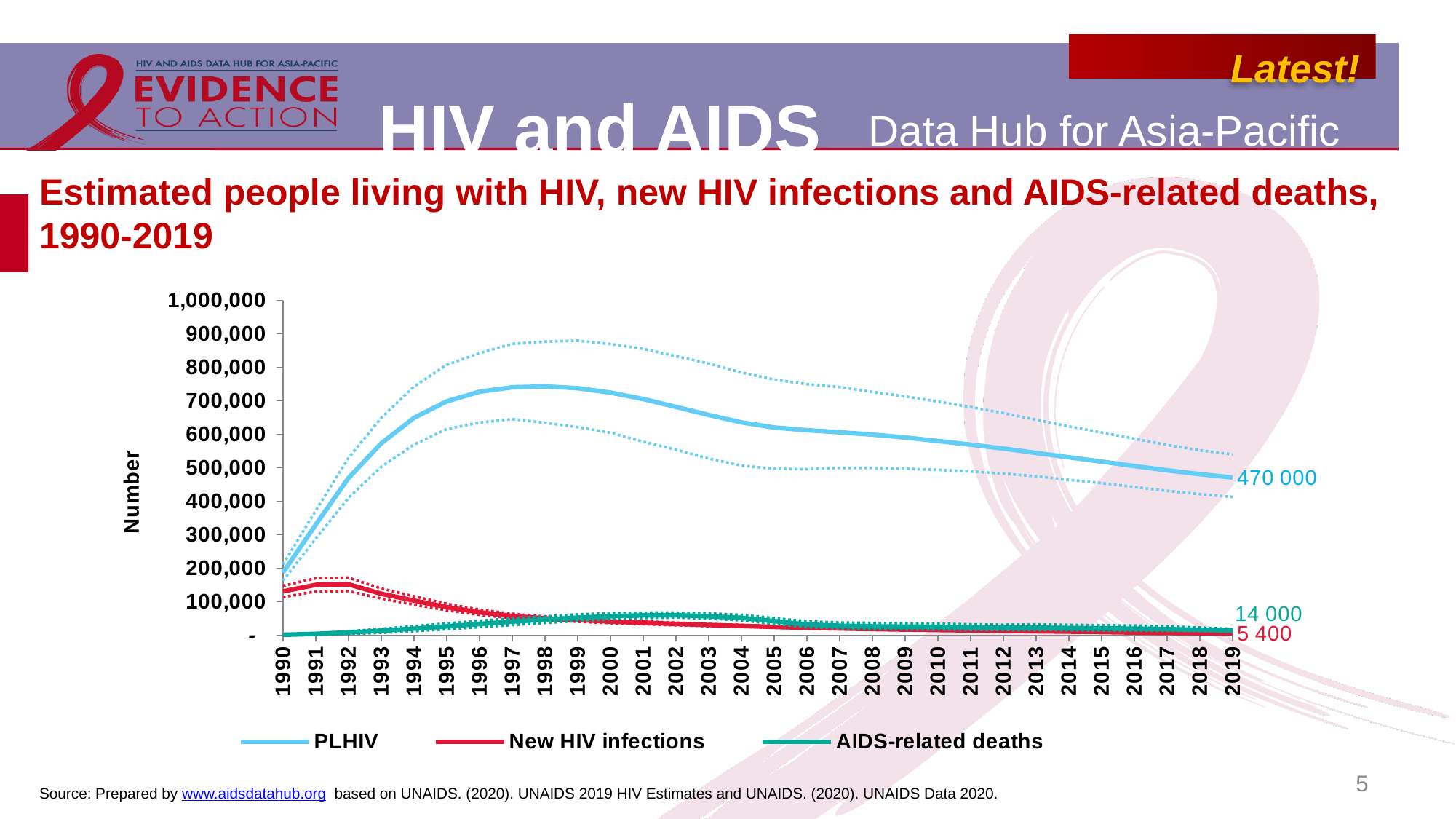
How many series does the legend list? 3 In 2019, which is larger: AIDS-related deaths or New HIV infections? AIDS-related deaths Does the PLHIV line rise or fall from 1998 to 2019? fall What kind of chart is shown on the slide? line chart Which series has the highest value in 2019? PLHIV What is the value for New HIV infections in 2019? 5 400 What is the value for PLHIV in 2019? 470 000 Is the value for PLHIV in 1998 greater or less than 600,000? greater Is the value for PLHIV in 1990 greater or less than 300,000? less What is the difference between AIDS-related deaths and New HIV infections in 2019? 8 600 What is the title of the vertical axis? Number What is the value for AIDS-related deaths in 2019? 14 000